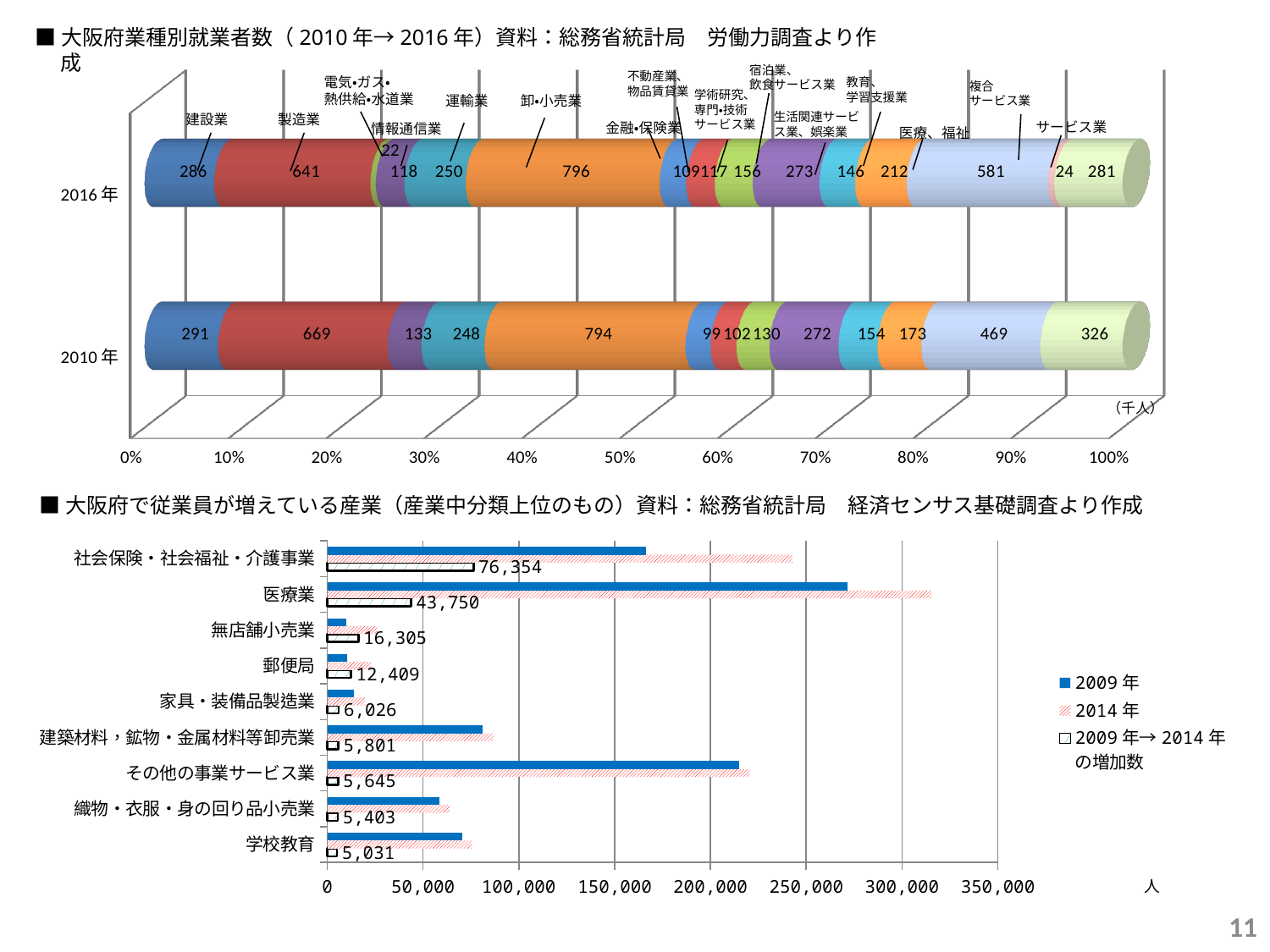
In the top chart (大阪府業種別就業者数), what is the value for 製造業 in 2010年? 669 In the top chart (大阪府業種別就業者数), which industry has the largest value in the 2016年 bar? 卸・小売業 In the top chart (大阪府業種別就業者数), what is the value for 卸・小売業 in 2016年? 796 In the bottom chart (大阪府で従業員が増えている産業), which industry has the largest 2009年→2014年の増加数? 社会保険・社会福祉・介護事業 In the bottom chart (大阪府で従業員が増えている産業), is the 2009年 value for 医療業 greater or less than 250,000? greater In the bottom chart (大阪府で従業員が増えている産業), which industry has the smallest 2009年→2014年の増加数? 学校教育 In the bottom chart (大阪府で従業員が増えている産業), how many series does the legend list? 3 In the top chart (大阪府業種別就業者数), what is the value for 医療、福祉 in 2016年? 581 In the top chart (大阪府業種別就業者数), which is larger: サービス業 in 2010年 or サービス業 in 2016年? 2010年 In the top chart (大阪府業種別就業者数), how many bars (years) are shown? 2 In the top chart (大阪府業種別就業者数), by how much did the value for 製造業 change from 2010年 (669) to 2016年 (641)? 28 In the bottom chart (大阪府で従業員が増えている産業), what is the 2009年→2014年の増加数 for 医療業? 43,750